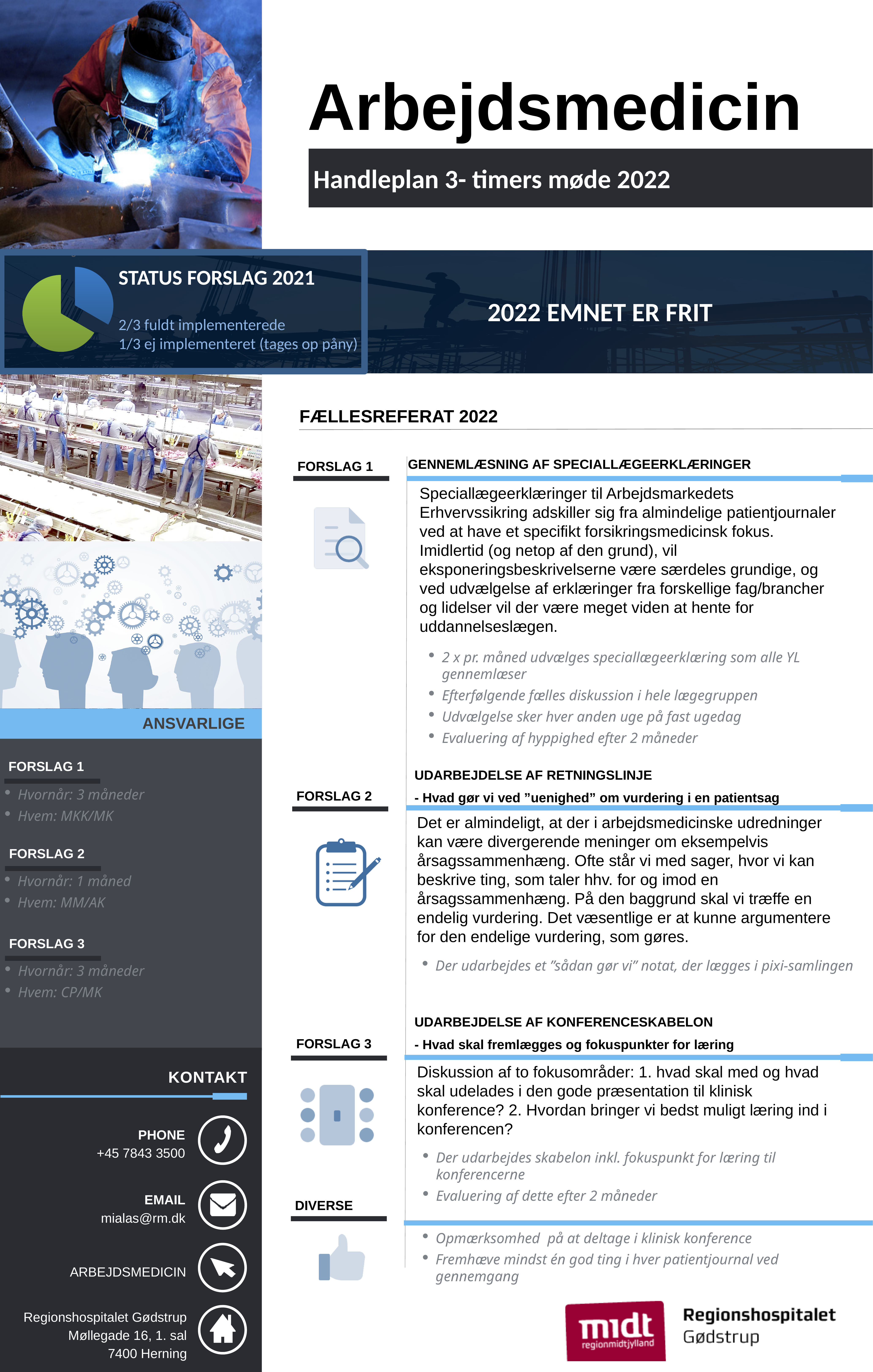
In the STATUS FORSLAG 2021 pie chart, which category has the smallest slice? ej implementeret What kind of chart is shown in the STATUS FORSLAG 2021 box? pie chart What colour is the slice for fully implemented proposals in the STATUS FORSLAG 2021 pie chart? green In the STATUS FORSLAG 2021 pie chart, what share of the proposals are fully implemented (fuldt implementerede)? 2/3 In the STATUS FORSLAG 2021 pie chart, is the share of fully implemented proposals larger or smaller than the share of not implemented proposals? larger What is the title of the box containing the pie chart? STATUS FORSLAG 2021 In the STATUS FORSLAG 2021 pie chart, what share of the proposals are not implemented (ej implementeret)? 1/3 In the STATUS FORSLAG 2021 pie chart, which category has the largest slice? fuldt implementerede In the STATUS FORSLAG 2021 pie chart, is the share of fully implemented proposals greater or less than 50%? greater How many slices does the STATUS FORSLAG 2021 pie chart have? 2